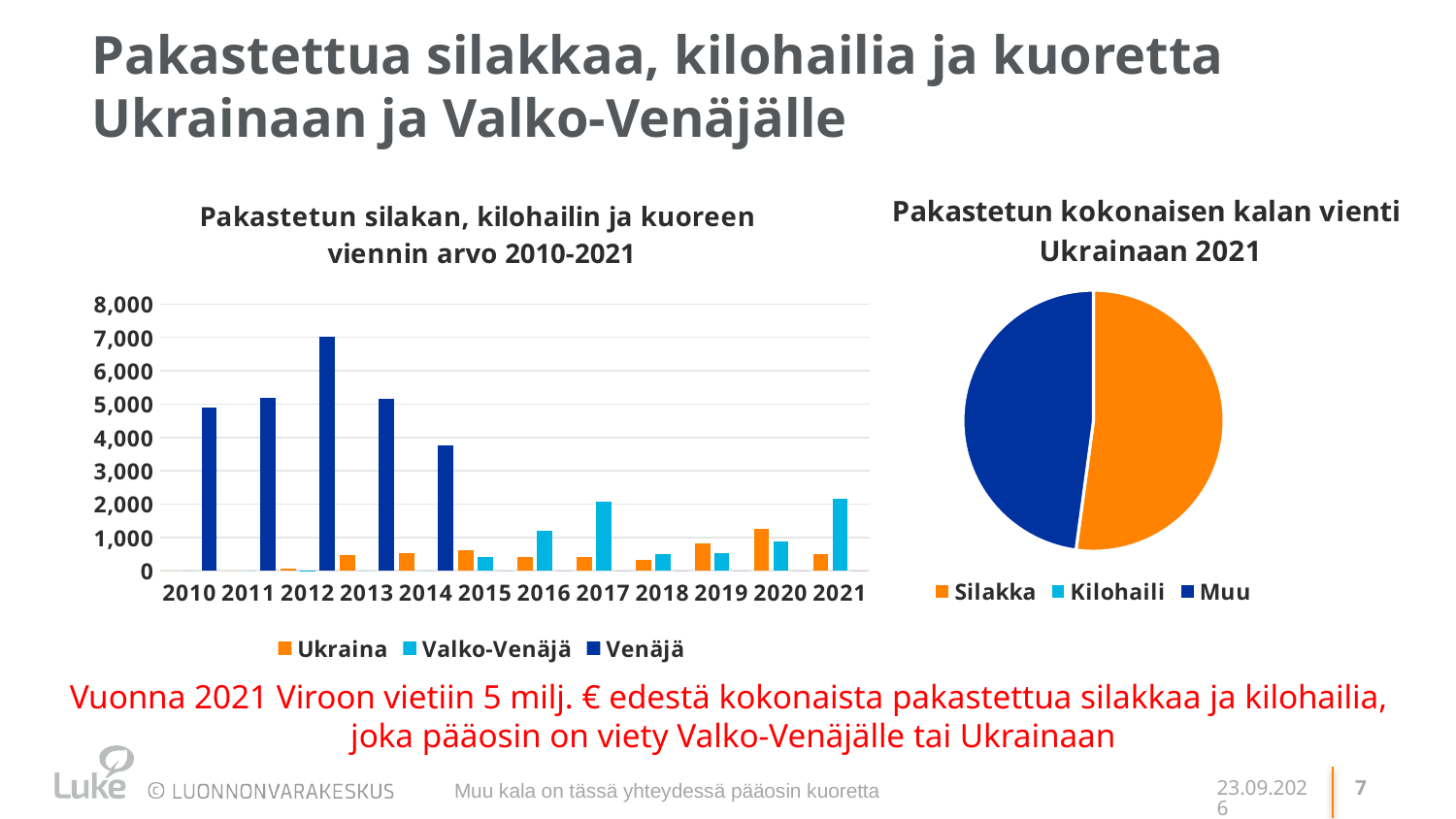
In the left bar chart, how many years are shown on the x axis? 12 In the left bar chart, how many series does the legend list? 3 In the left bar chart, is the Ukraina value for 2018 greater or less than 1,000? less What kind of chart is the right chart, 'Pakastetun kokonaisen kalan vienti Ukrainaan 2021'? pie chart What kind of chart is the left chart, 'Pakastetun silakan, kilohailin ja kuoreen viennin arvo 2010-2021'? bar chart In the left bar chart, is the Valko-Venäjä value for 2017 greater or less than 1,000? greater In the left bar chart, does the Venäjä series rise or fall from 2012 to 2014? fall In the left bar chart, is the Venäjä value for 2012 greater or less than 6,000? greater In the left bar chart, in which year is the Venäjä value highest? 2012 In the right pie chart, how many categories does the legend list? 3 In the left bar chart, which is larger in 2017: the Ukraina value or the Valko-Venäjä value? Valko-Venäjä